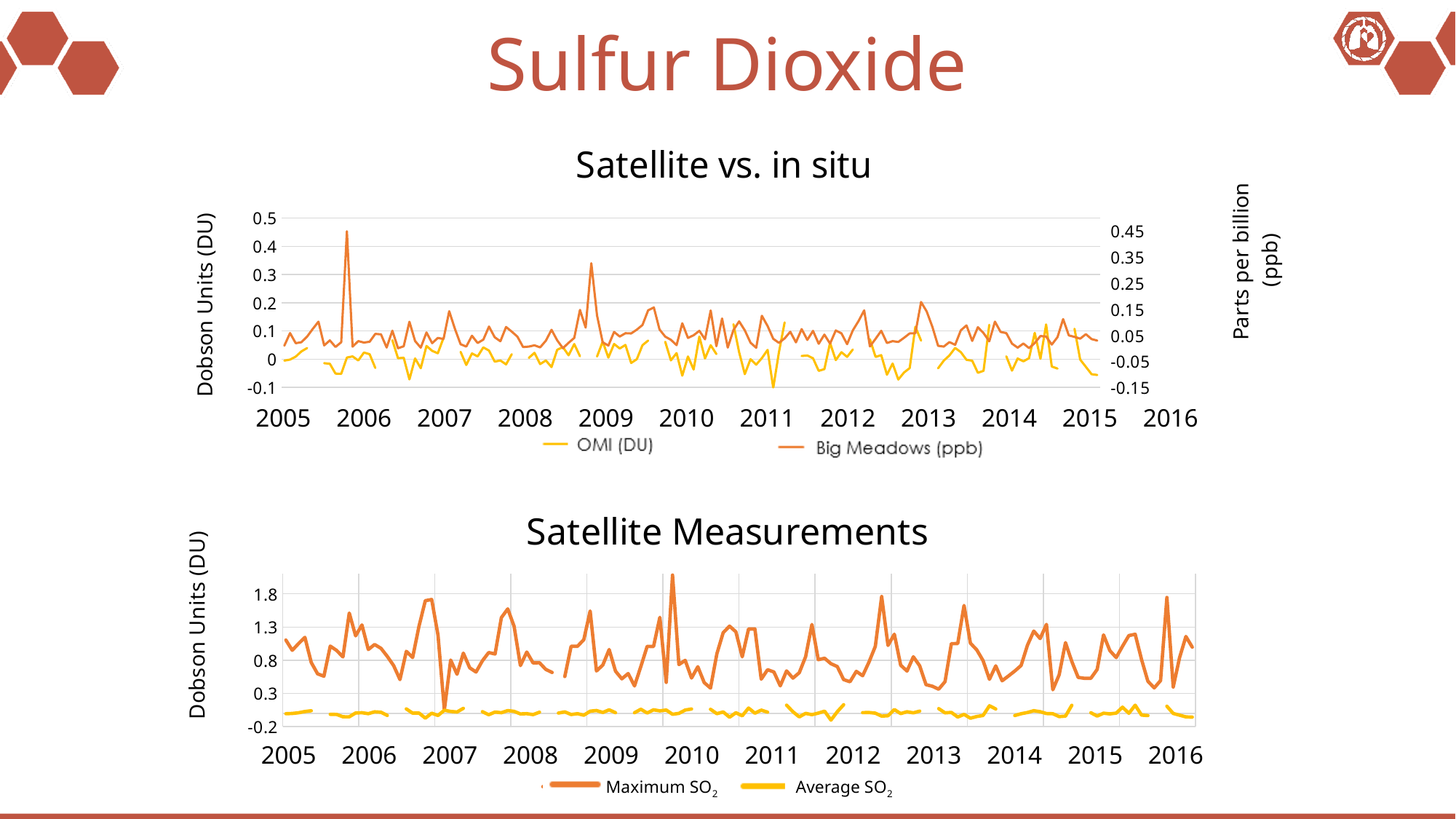
In the 'Satellite vs. in situ' chart, is the highest value of the OMI (DU) series greater or less than 0.3? less In the 'Satellite vs. in situ' chart, what is the title of the right-hand vertical axis? Parts per billion (ppb) How many year labels are shown on the x axis of the 'Satellite Measurements' chart? 12 In the 'Satellite Measurements' chart, is the highest value of the Average SO2 series greater or less than 0.8? less In the 'Satellite vs. in situ' chart, is the peak Big Meadows (ppb) value near the end of 2005 greater or less than 0.25 ppb? greater In the 'Satellite vs. in situ' chart, what are the two series named in the legend? OMI (DU) and Big Meadows (ppb) What kind of chart is the 'Satellite vs. in situ' chart? line chart What kind of chart is the 'Satellite Measurements' chart? line chart How many series does the legend of the 'Satellite vs. in situ' chart list? 2 In the 'Satellite Measurements' chart, which series has the higher values throughout, Maximum SO2 or Average SO2? Maximum SO2 How many series does the legend of the 'Satellite Measurements' chart list? 2